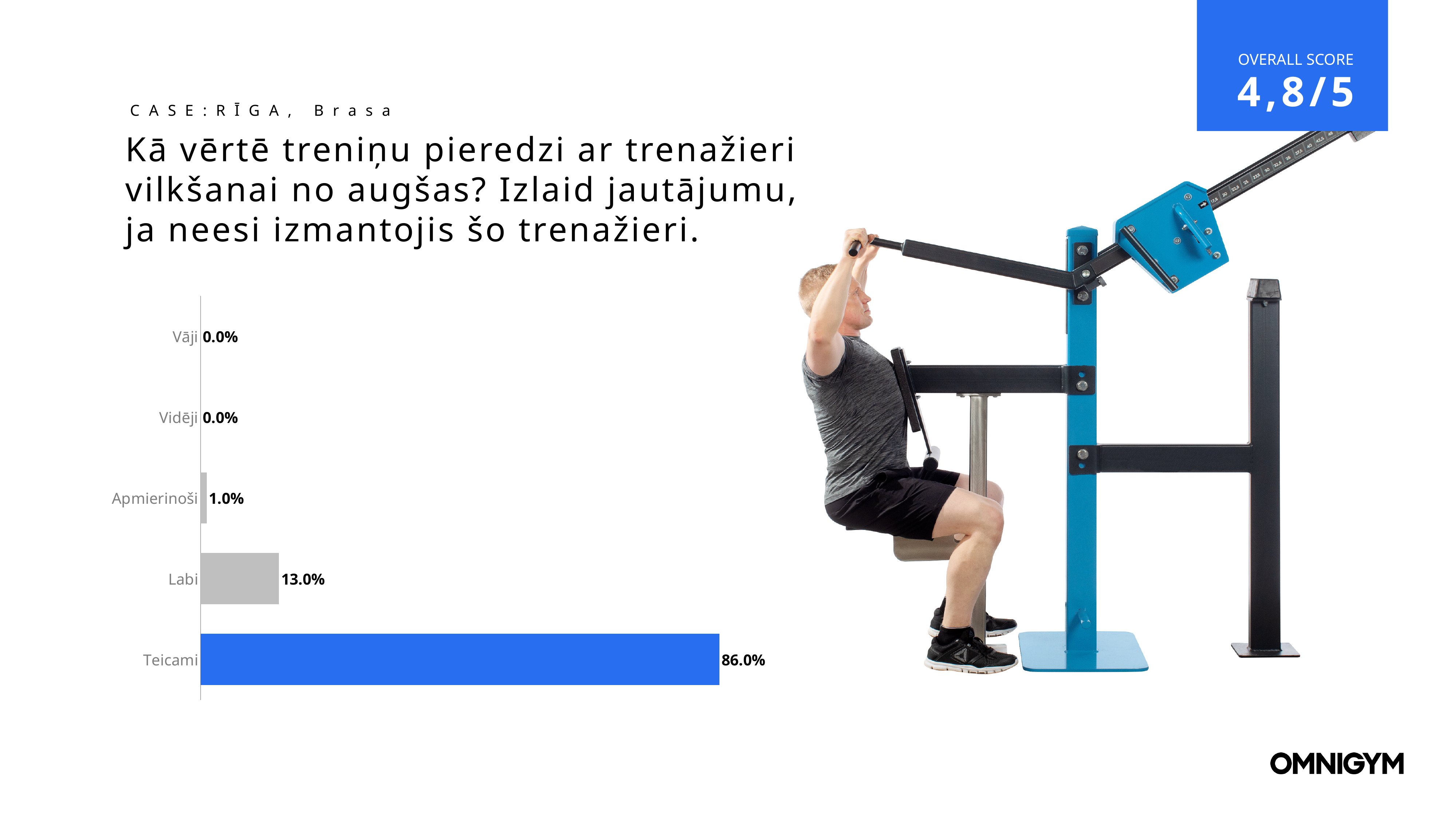
What is the difference between the values for Labi and Apmierinoši? 12.0% What is the value for Teicami? 86.0% What is the value for Apmierinoši? 1.0% What is the value for Labi? 13.0% What kind of chart is shown on the slide? Bar chart Which category has the highest value? Teicami What overall score is shown in the box at the top right of the slide? 4,8/5 How many categories are shown in the chart? 5 What is the value for Vidēji? 0.0% What is the difference between the values for Teicami and Labi? 73.0% What is the value for Vāji? 0.0% Which is larger, the value for Labi or the value for Apmierinoši? Labi